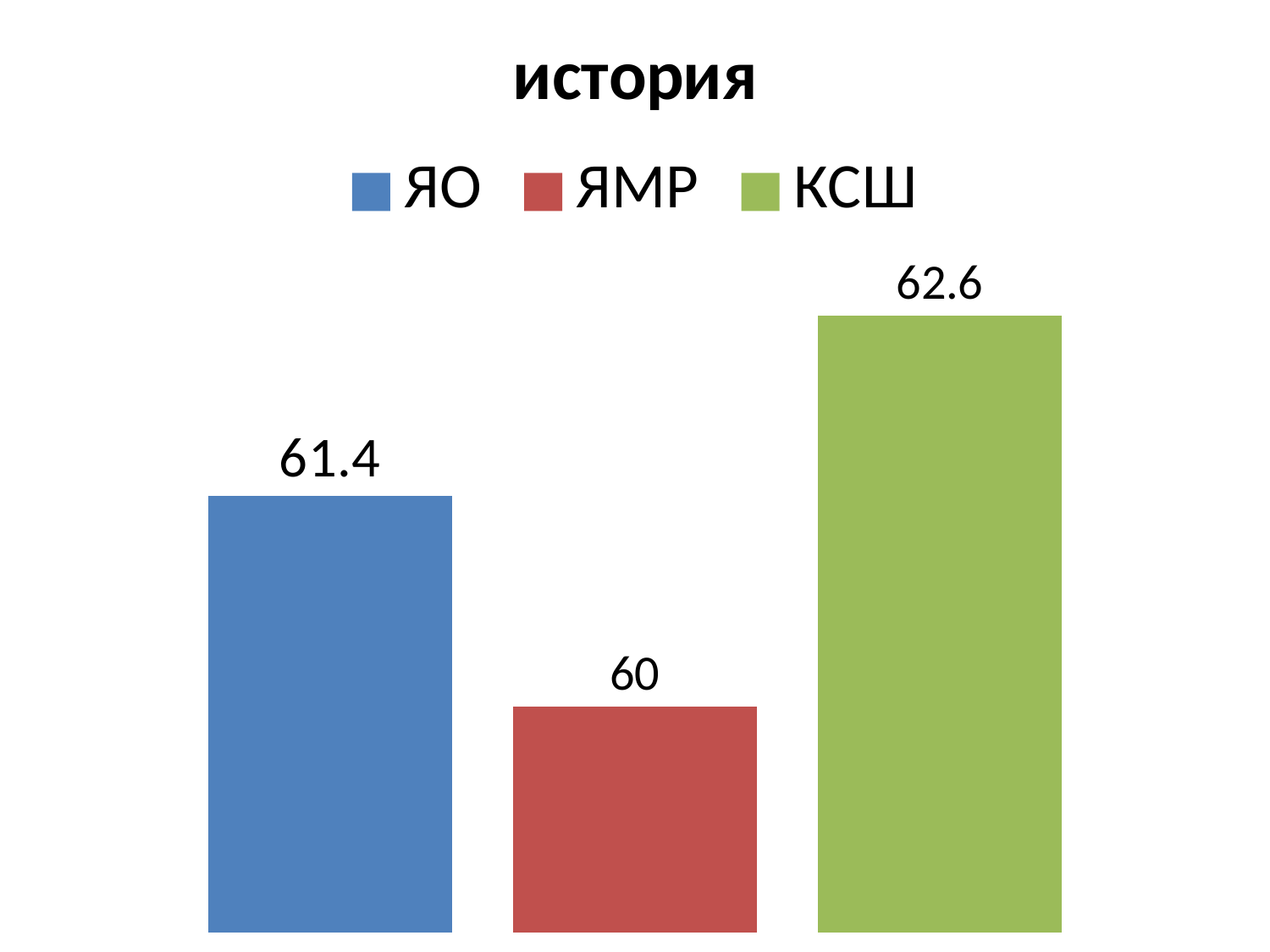
What is the difference between the values for ЯО and ЯМР? 1.4 Which series has the lowest value? ЯМР Which series has the highest value? КСШ How many bars are plotted on the chart? 3 What kind of chart is shown? bar chart What is the title of the chart? история Which is larger, the value for ЯО or the value for КСШ? КСШ How many series does the legend list? 3 What is the value for ЯМР? 60 What is the value for ЯО? 61.4 What is the difference between the values for КСШ and ЯМР? 2.6 What is the value for КСШ? 62.6